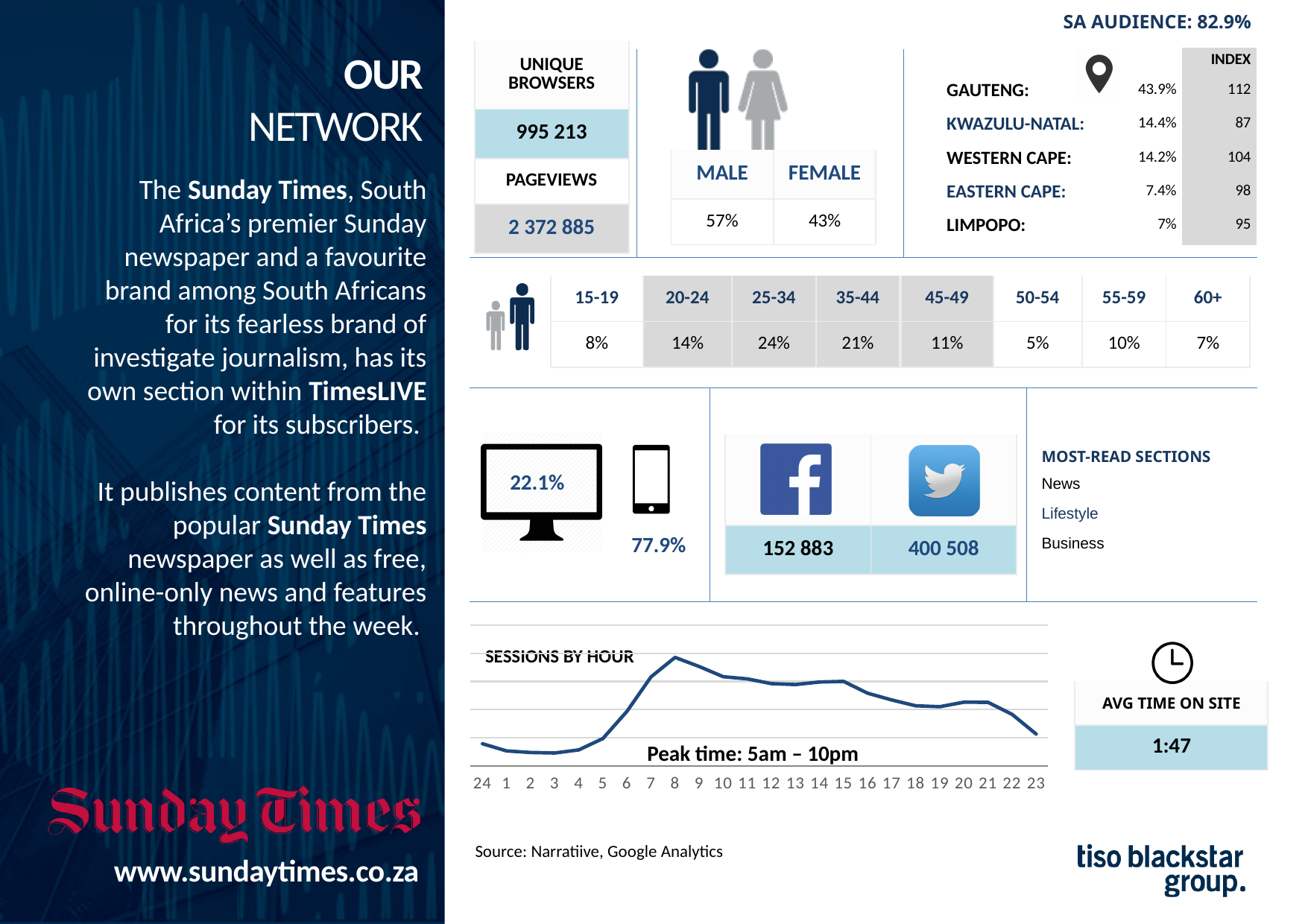
How many hourly points are plotted along the x axis of the 'Sessions by Hour' chart? 24 In the 'Sessions by Hour' chart, do sessions rise or fall between hour 3 and hour 8? rise In the 'Sessions by Hour' chart, do sessions rise or fall between hour 15 and hour 23? fall In the 'Sessions by Hour' chart, which hour has more sessions, hour 8 or hour 23? hour 8 In the 'Sessions by Hour' chart, which hour has more sessions, hour 10 or hour 20? hour 10 What peak time is annotated on the 'Sessions by Hour' chart? 5am – 10pm What is the first hour label on the x axis of the 'Sessions by Hour' chart? 24 In the 'Sessions by Hour' chart, which hour has more sessions, hour 2 or hour 12? hour 12 What is the title of the line chart at the bottom of the slide? Sessions by Hour What kind of chart is the 'Sessions by Hour' chart? line chart In the 'Sessions by Hour' chart, at which hour does the line reach its highest point? 8